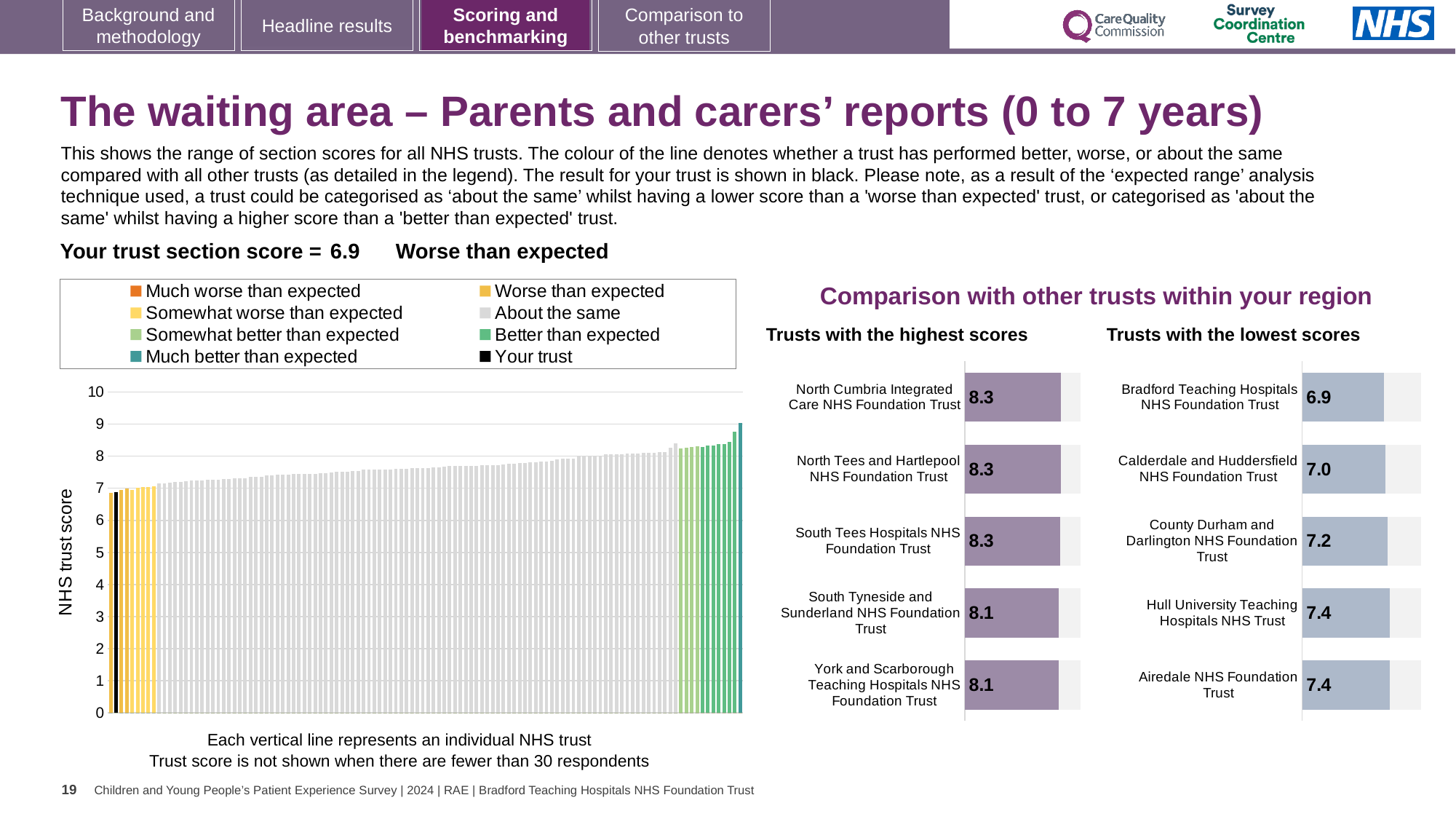
In the large chart on the left showing all NHS trusts, is the value of the tallest bar greater or less than 8? greater In the 'Trusts with the lowest scores' chart, which trust has the lowest score? Bradford Teaching Hospitals NHS Foundation Trust In the large chart on the left showing all NHS trusts, what kind of chart is it? Bar chart In the 'Trusts with the lowest scores' chart, what is the difference between the scores of Airedale NHS Foundation Trust and Bradford Teaching Hospitals NHS Foundation Trust? 0.5 In the 'Trusts with the highest scores' chart, what is the score for North Cumbria Integrated Care NHS Foundation Trust? 8.3 In the 'Trusts with the highest scores' chart, what is the difference between the scores of North Cumbria Integrated Care NHS Foundation Trust and York and Scarborough Teaching Hospitals NHS Foundation Trust? 0.2 In the 'Trusts with the lowest scores' chart, what is the score for Calderdale and Huddersfield NHS Foundation Trust? 7.0 How many trusts are shown in the 'Trusts with the highest scores' chart? 5 In the 'Trusts with the lowest scores' chart, which has the higher score: Calderdale and Huddersfield NHS Foundation Trust or County Durham and Darlington NHS Foundation Trust? County Durham and Darlington NHS Foundation Trust In the large chart on the left showing all NHS trusts, do the bar heights rise or fall from left to right? Rise In the 'Trusts with the highest scores' chart, what is the score for York and Scarborough Teaching Hospitals NHS Foundation Trust? 8.1 How many entries does the legend above the large chart on the left list? 8